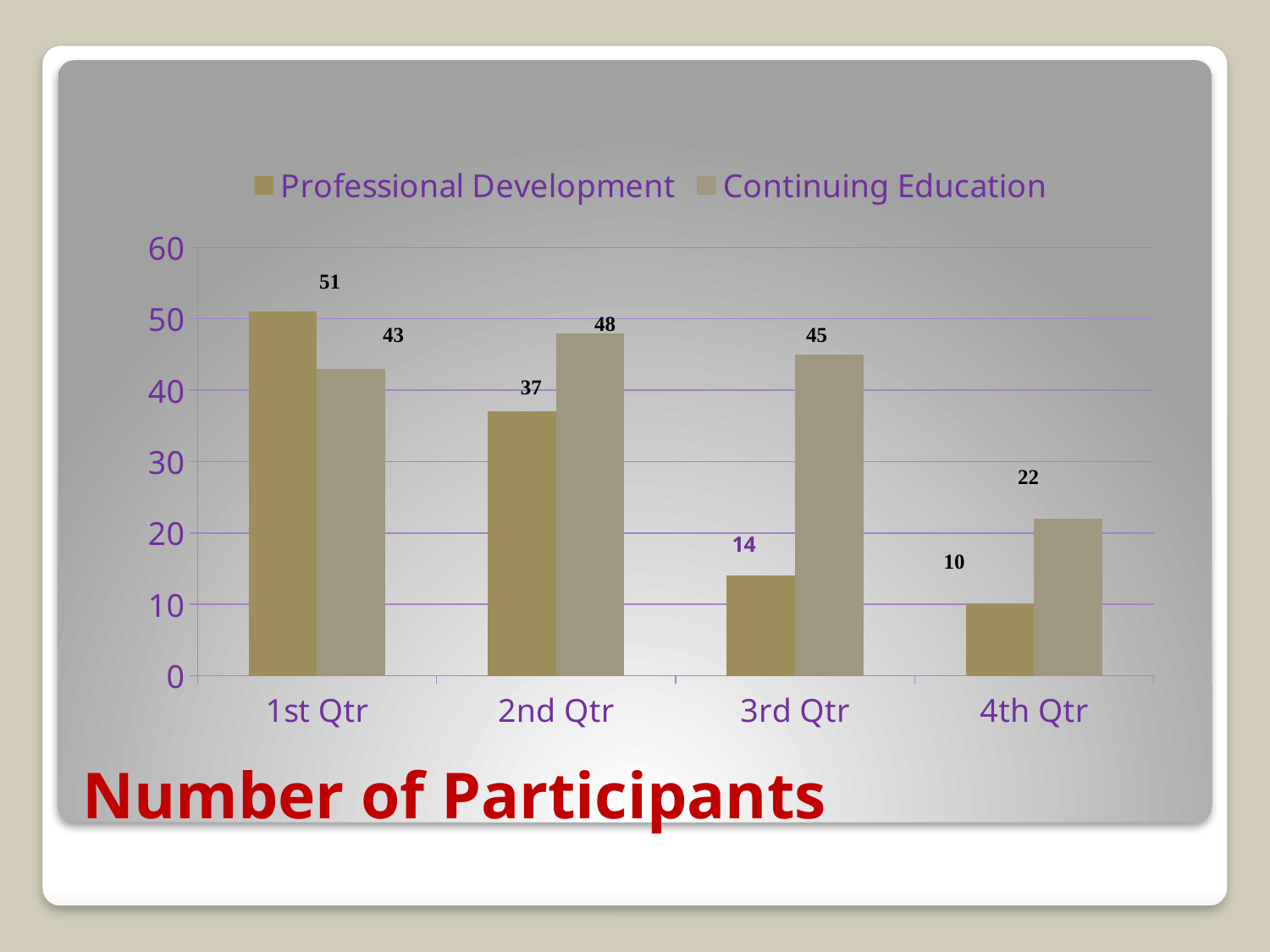
Do the Professional Development values rise or fall from 1st Qtr to 4th Qtr? Fall What is the value for Professional Development in 4th Qtr? 10 What is the difference between Professional Development and Continuing Education in 1st Qtr? 8 Which is larger in 2nd Qtr, Professional Development or Continuing Education? Continuing Education Which quarter has the highest value for Continuing Education? 2nd Qtr How many series does the legend list? 2 How many quarters are shown on the x axis? 4 What kind of chart is shown on the slide? Bar chart What is the difference between Continuing Education and Professional Development in 3rd Qtr? 31 What is the value for Continuing Education in 3rd Qtr? 45 What is the value for Professional Development in 1st Qtr? 51 Which quarter has the lowest value for Professional Development? 4th Qtr